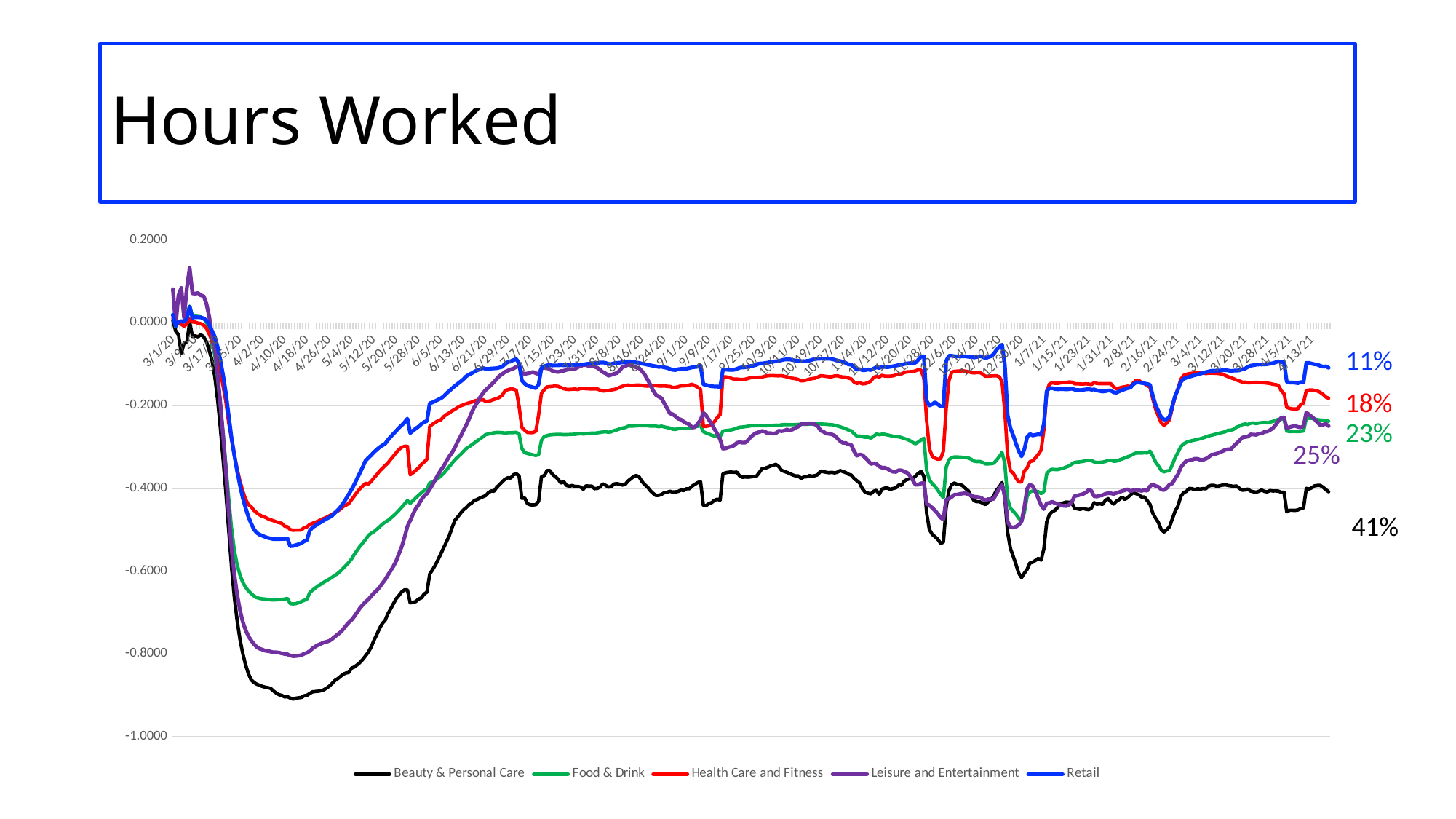
What percentage is annotated at the right edge of the chart next to the Food & Drink (green) line? 23% Between 4/10/20 and 6/21/20, do the lines generally rise or fall? rise What colour is the Retail line in the chart? blue What percentage is annotated at the right edge of the chart next to the Leisure and Entertainment (purple) line? 25% What percentage is annotated at the right edge of the chart next to the Retail (blue) line? 11% Is the lowest value reached by the Food & Drink line greater or less than -0.6000? less What kind of chart is shown on the slide? line chart Is the lowest value reached by the Beauty & Personal Care line greater or less than -0.8000? less What is the title of the slide containing the chart? Hours Worked What percentage is annotated at the right edge of the chart next to the Beauty & Personal Care (black) line? 41% Which series drops to the lowest value on the chart? Beauty & Personal Care How many series does the legend list? 5